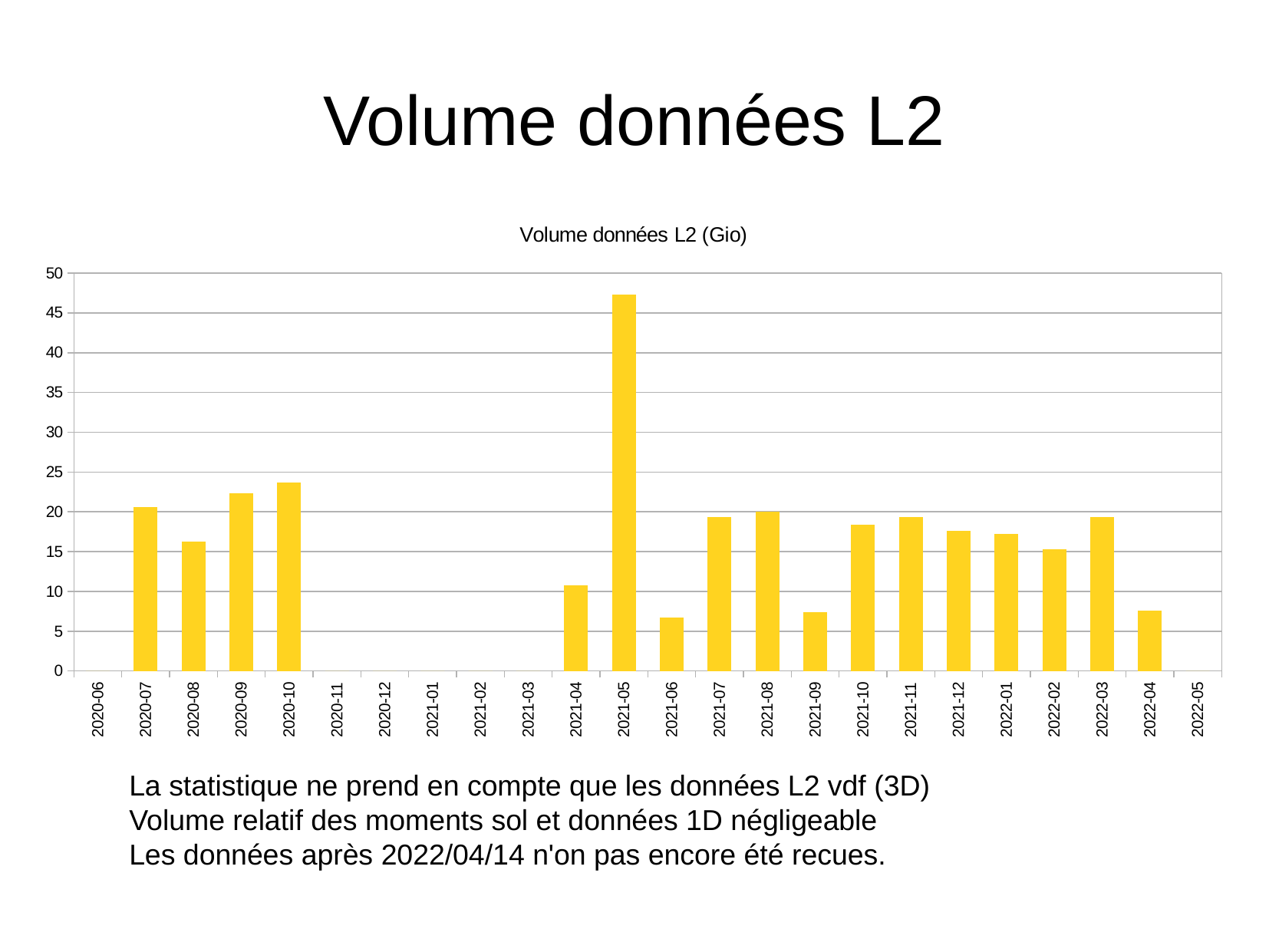
Do the values rise or fall from 2021-11 to 2022-02? fall Is the value for 2020-08 greater or less than 20? less Which has the larger value, 2020-10 or 2020-08? 2020-10 Which month has the highest bar in the chart? 2021-05 Is the value for 2020-10 greater or less than 20? greater Is the value for 2021-05 greater or less than 40? greater What kind of chart is shown on the slide? Bar chart How many months are listed along the x axis of the chart? 24 What is the title of the chart? Volume données L2 (Gio) Which has the larger value, 2021-04 or 2021-05? 2021-05